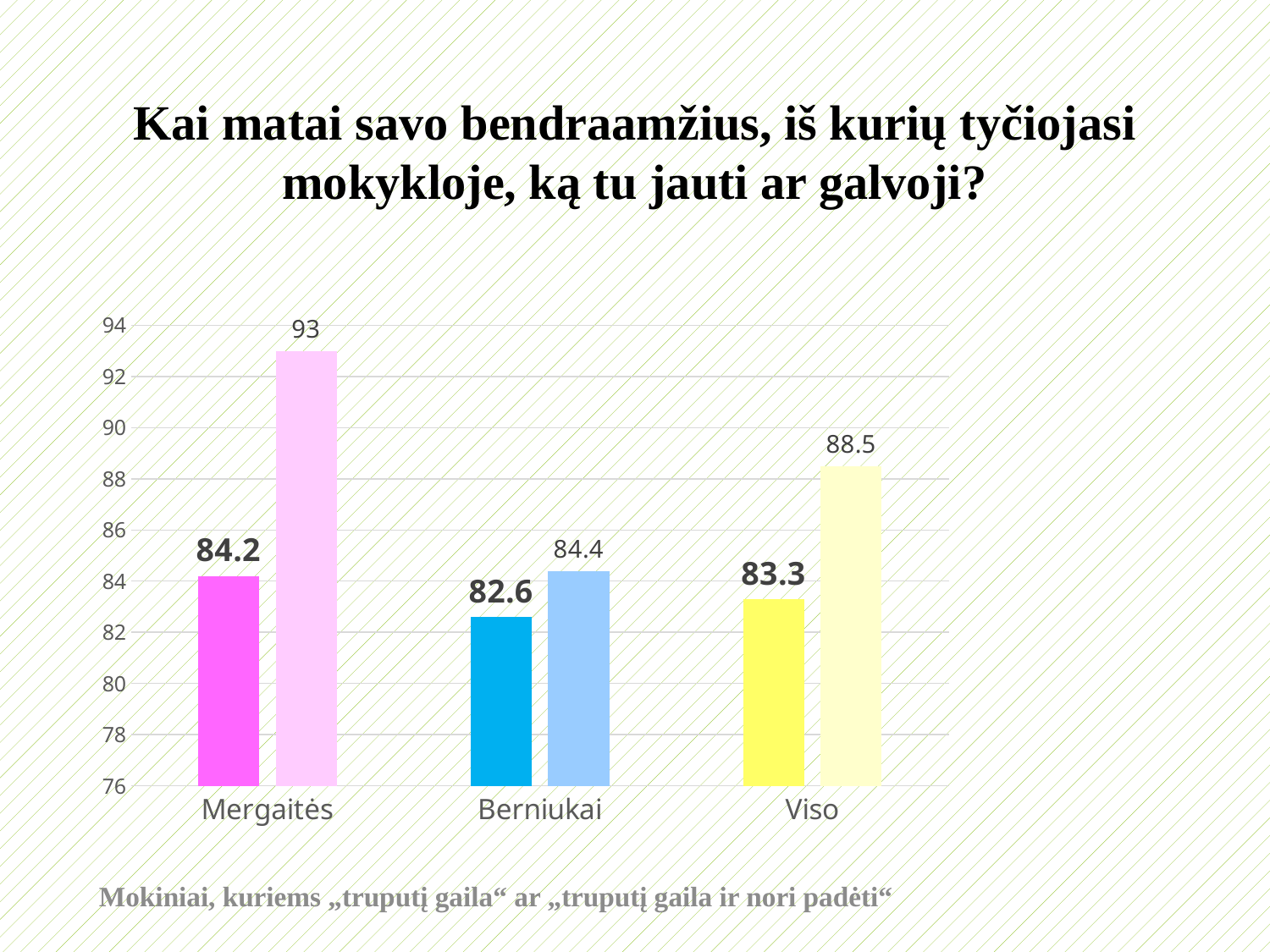
What is the lowest value shown on the vertical axis of the chart? 76 What is the value of the first (darker, bold-labelled) bar for Mergaitės? 84.2 Which category has the lowest bar in the chart? Berniukai What type of chart is shown on the slide? bar chart How many categories are shown on the x axis of the chart? 3 Which category has the tallest bar in the chart? Mergaitės What is the value of the second (lighter) bar for Mergaitės? 93 What is the difference between the two bars for Berniukai (84.4 and 82.6)? 1.8 What is the difference between the two bars for Mergaitės (93 and 84.2)? 8.8 What is the value of the first (darker, bold-labelled) bar for Berniukai? 82.6 Which is larger: the first (darker) bar for Mergaitės or the first (darker) bar for Viso? Mergaitės What is the value of the second (lighter) bar for Viso? 88.5